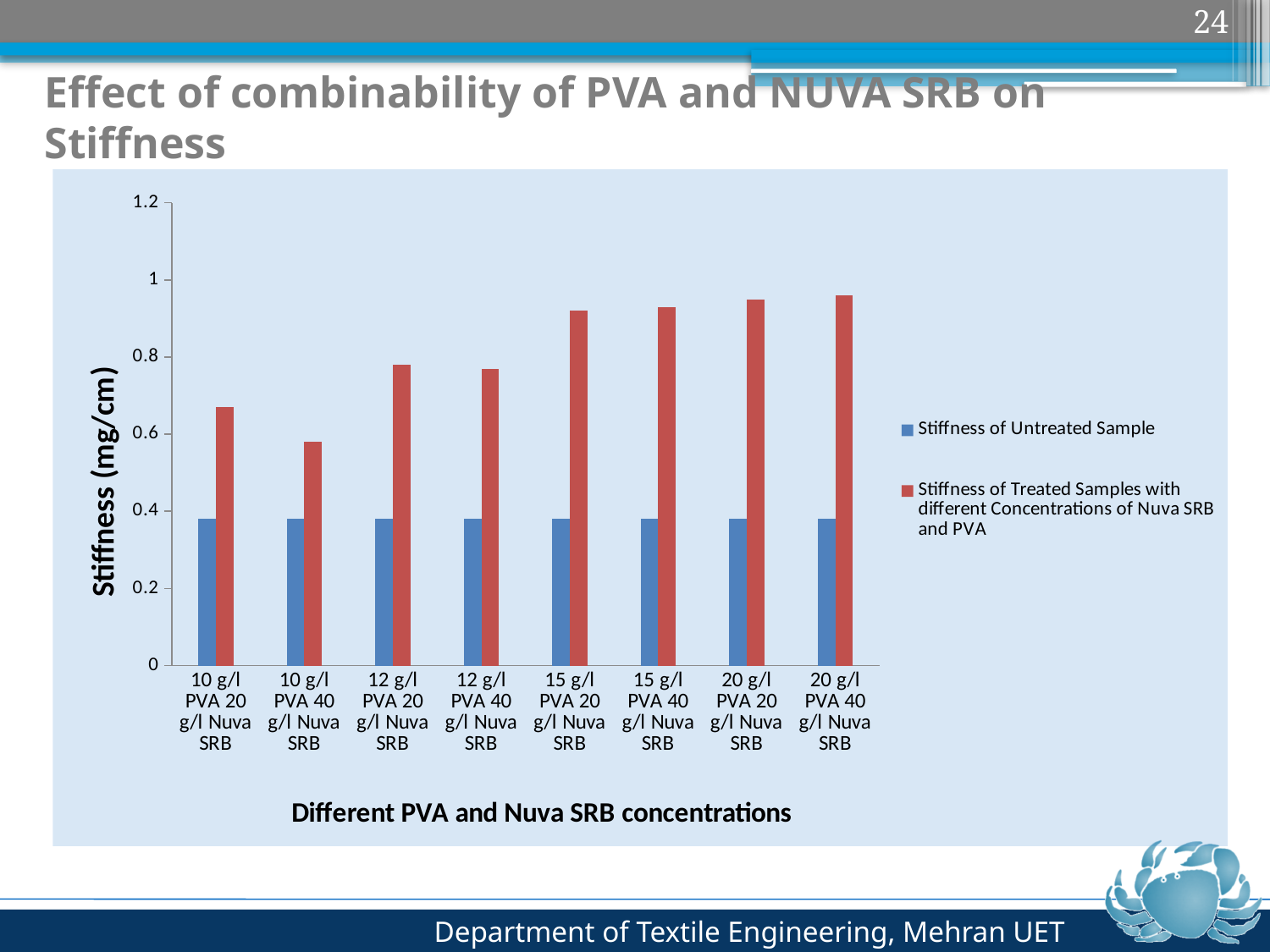
How many series does the legend list? 2 Do the treated-sample stiffness values generally rise or fall as the PVA concentration increases along the x axis? rise Which colour represents the Stiffness of Untreated Sample series? blue How many concentration categories are shown on the x axis? 8 Which category has the lowest stiffness for the treated samples? 10 g/l PVA 40 g/l Nuva SRB Is the stiffness of the untreated sample greater or less than 0.4? less Is the treated-sample stiffness for 10 g/l PVA 20 g/l Nuva SRB greater or less than 0.6? greater What kind of chart is shown on the slide? bar chart Which is larger for the treated samples: the stiffness at 12 g/l PVA 20 g/l Nuva SRB or at 10 g/l PVA 40 g/l Nuva SRB? 12 g/l PVA 20 g/l Nuva SRB Is the treated-sample stiffness for 15 g/l PVA 20 g/l Nuva SRB greater or less than 0.8? greater What is the label of the vertical axis? Stiffness (mg/cm)